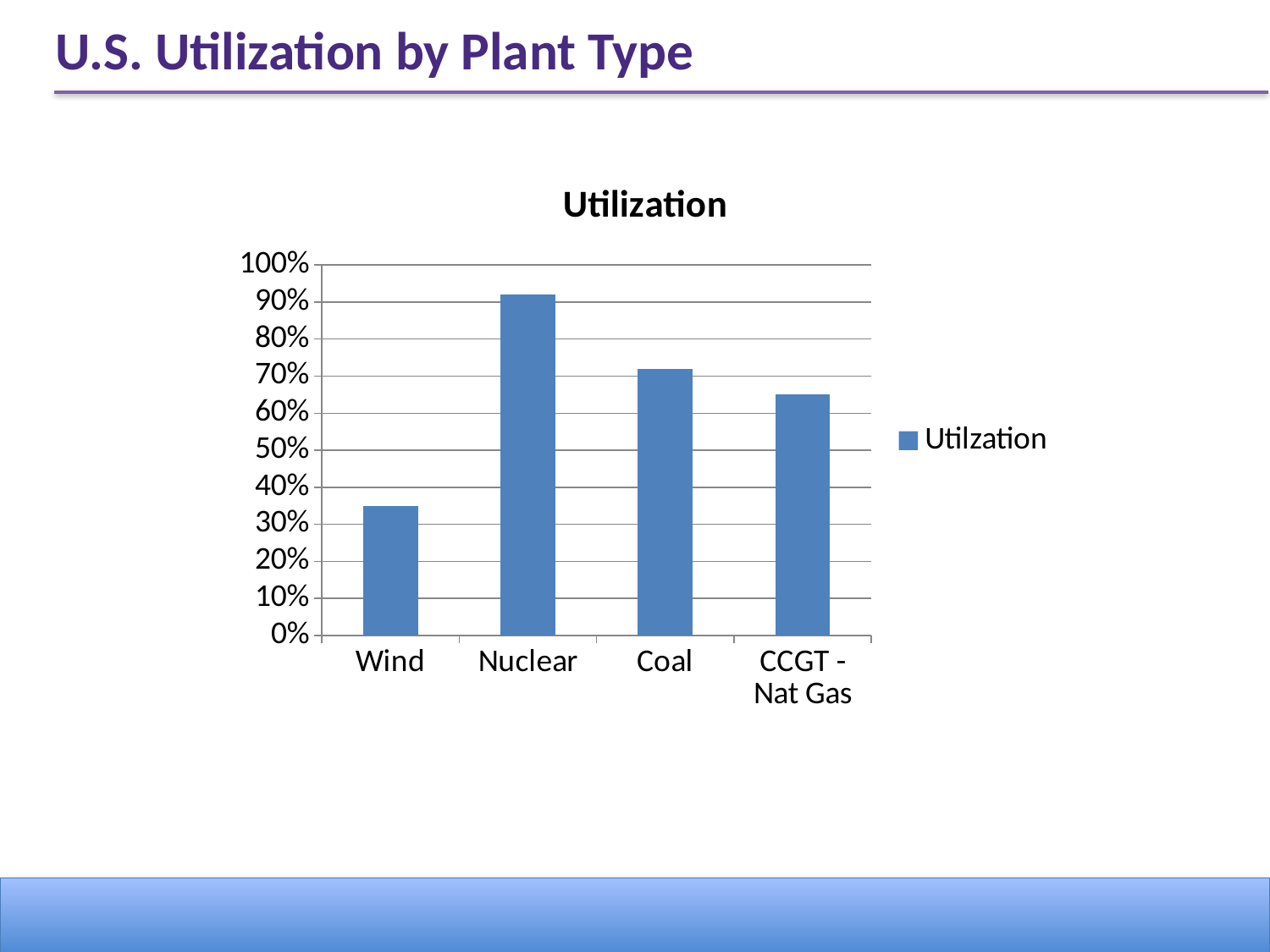
What type of chart is shown on the slide? bar chart What is the title of the chart? Utilization How many series does the legend list? 1 Which plant type has the lowest utilization? Wind Is the value for CCGT - Nat Gas greater or less than 70%? less What is the legend entry shown next to the chart? Utilzation Which plant type has the highest utilization? Nuclear Is the value for Nuclear greater or less than 90%? greater Is the value for Wind greater or less than 40%? less Which has a higher utilization, Coal or CCGT - Nat Gas? Coal How many plant types are shown on the x axis? 4